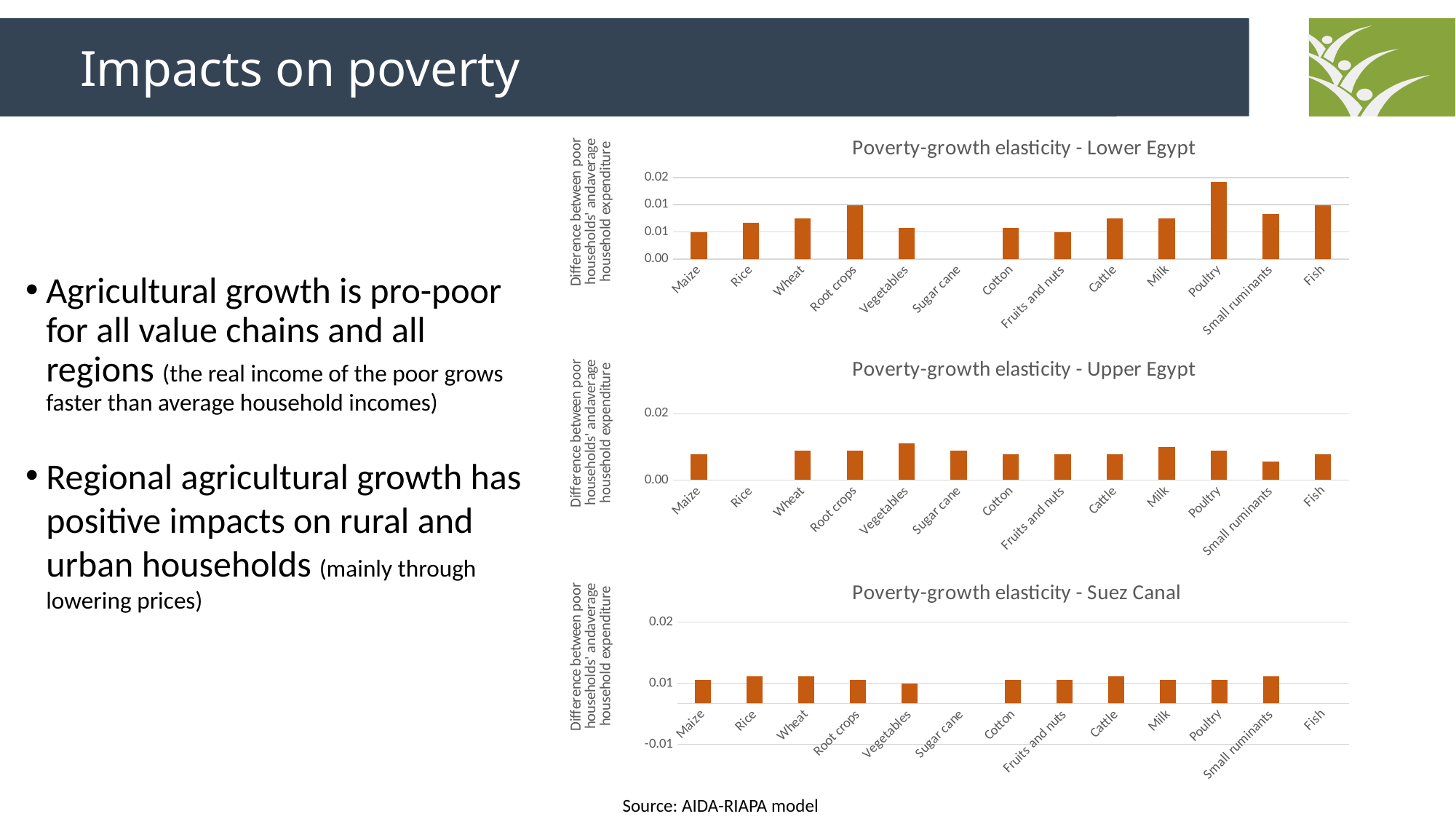
In the 'Poverty-growth elasticity - Lower Egypt' chart, is the value for Poultry greater or less than 0.01? greater What is the title of the bottom chart on the slide? Poverty-growth elasticity - Suez Canal In the 'Poverty-growth elasticity - Suez Canal' chart, is the value for Cattle greater or less than 0.02? less In the 'Poverty-growth elasticity - Upper Egypt' chart, which category shows no bar at all? Rice In the 'Poverty-growth elasticity - Lower Egypt' chart, which category shows no bar at all? Sugar cane In the 'Poverty-growth elasticity - Upper Egypt' chart, which category has the highest value? Vegetables How many categories are shown on the x axis of the 'Poverty-growth elasticity - Lower Egypt' chart? 13 In the 'Poverty-growth elasticity - Lower Egypt' chart, which category has the highest value? Poultry What kind of chart is 'Poverty-growth elasticity - Suez Canal'? bar chart In the 'Poverty-growth elasticity - Lower Egypt' chart, which is larger, the value for Poultry or the value for Fish? Poultry In the 'Poverty-growth elasticity - Upper Egypt' chart, is the value for Poultry greater or less than 0.02? less